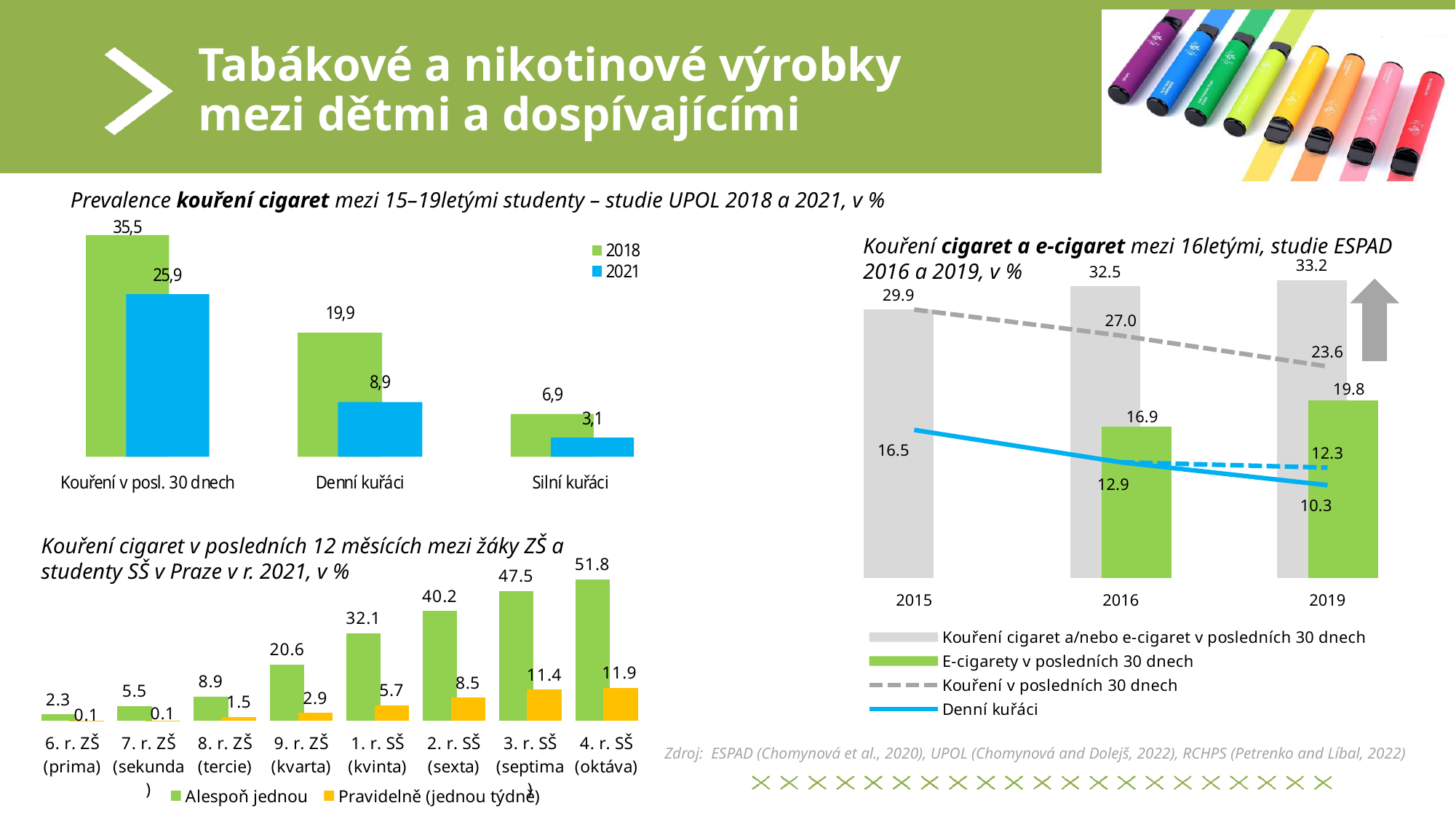
In the right chart (Kouření cigaret a e-cigaret mezi 16letými, studie ESPAD), which is larger in 2019: Kouření cigaret a/nebo e-cigaret v posledních 30 dnech or Kouření v posledních 30 dnech? Kouření cigaret a/nebo e-cigaret v posledních 30 dnech In the right chart (Kouření cigaret a e-cigaret mezi 16letými, studie ESPAD), what is the value for E-cigarety v posledních 30 dnech in 2019? 19.8 In the right chart (Kouření cigaret a e-cigaret mezi 16letými, studie ESPAD), what is the Denní kuřáci value in 2016? 12.9 In the top-left chart (Prevalence kouření cigaret, studie UPOL), how many series does the legend list? 2 In the bottom-left chart (Kouření cigaret v posledních 12 měsících, Praha 2021), which category has the highest Pravidelně (jednou týdně) value? 4. r. SŠ (oktáva) In the top-left chart (Prevalence kouření cigaret, studie UPOL), what is the 2021 value for Denní kuřáci? 8,9 In the bottom-left chart (Kouření cigaret v posledních 12 měsících, Praha 2021), what is the Alespoň jednou value for 2. r. SŠ (sexta)? 40.2 In the bottom-left chart (Kouření cigaret v posledních 12 měsících, Praha 2021), do the Alespoň jednou values rise or fall from 6. r. ZŠ to 4. r. SŠ? rise In the bottom-left chart (Kouření cigaret v posledních 12 měsících, Praha 2021), what kind of chart is it? bar chart In the bottom-left chart (Kouření cigaret v posledních 12 měsících, Praha 2021), how many categories are shown on the x axis? 8 In the top-left chart (Prevalence kouření cigaret, studie UPOL), what is the 2018 value for Kouření v posl. 30 dnech? 35,5 In the top-left chart (Prevalence kouření cigaret, studie UPOL), what is the difference between the 2018 and 2021 values for Silní kuřáci? 3,8